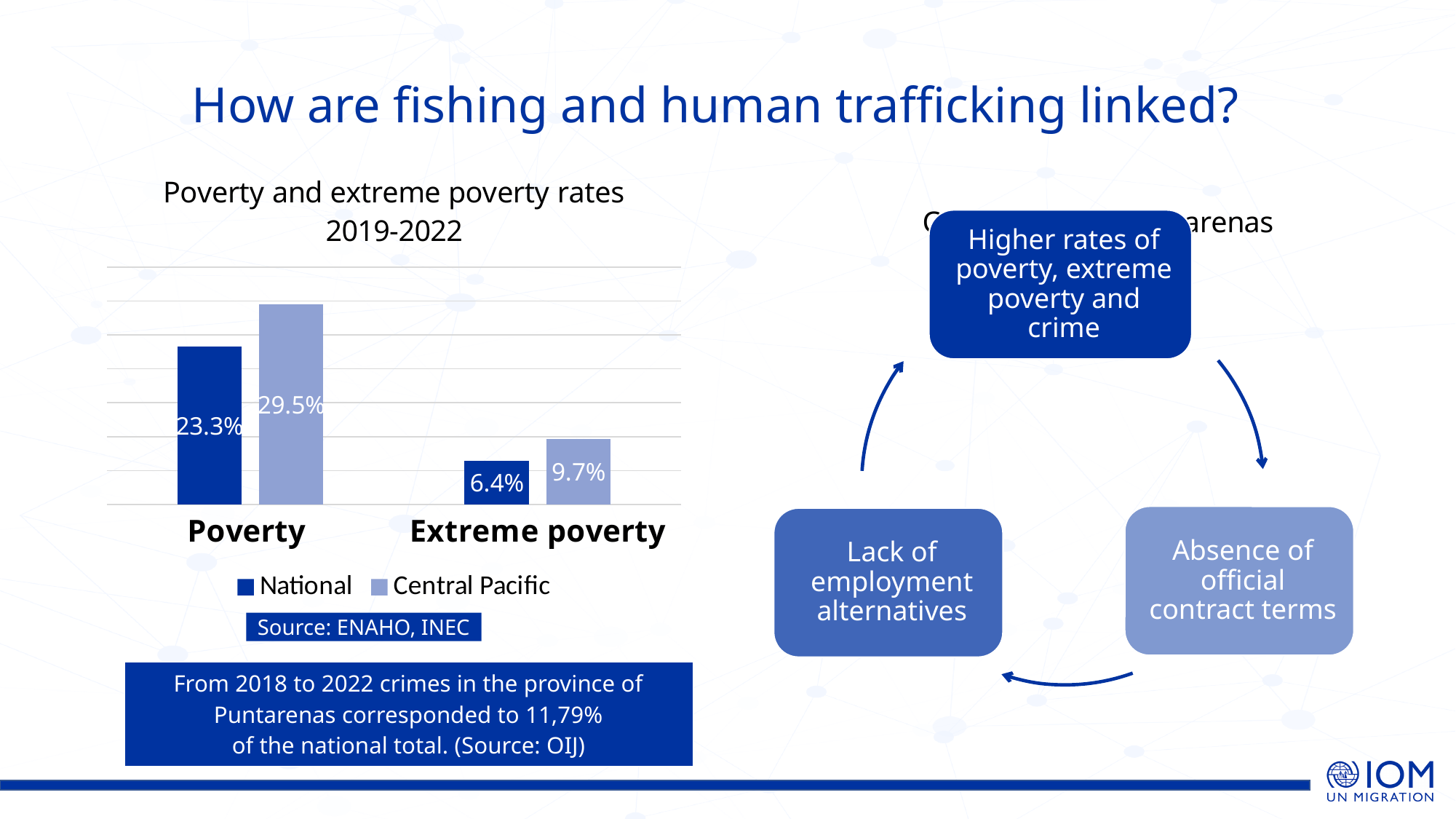
What is the Central Pacific poverty rate shown in the chart? 29.5% What type of chart is used to show the poverty and extreme poverty rates? Bar chart How many categories are shown on the x axis of the chart? 2 What is the National extreme poverty rate shown in the chart? 6.4% What is the National poverty rate shown in the chart? 23.3% What is the difference between the Central Pacific and National extreme poverty rates? 3.3 How many series does the chart legend list? 2 Which bar in the chart has the highest value? Central Pacific, Poverty What is the Central Pacific extreme poverty rate shown in the chart? 9.7% Which bar in the chart has the lowest value? National, Extreme poverty How many percentage points higher is the Central Pacific poverty rate than the National poverty rate? 6.2 For extreme poverty, which is larger: the National rate or the Central Pacific rate? Central Pacific